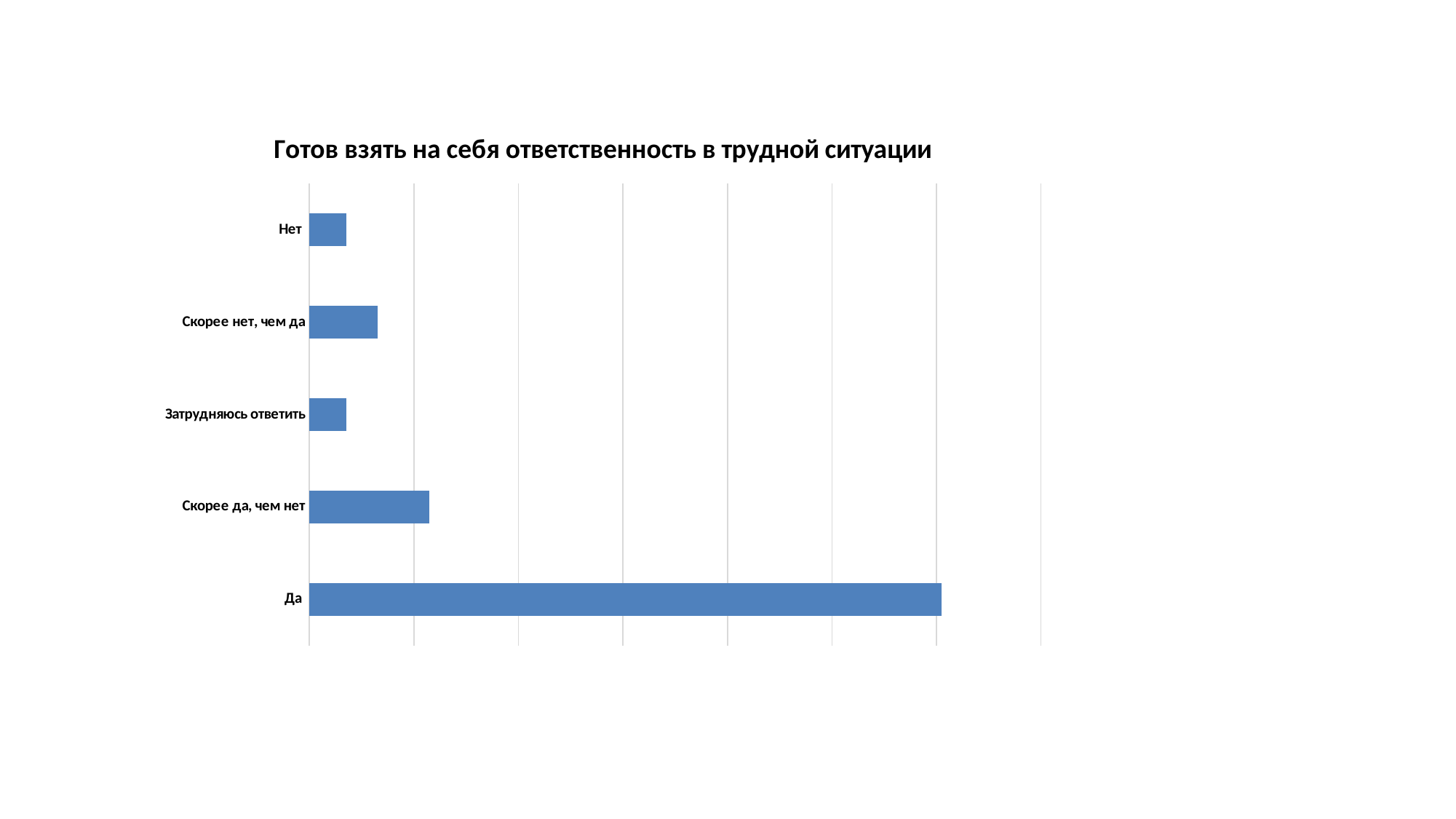
What colour are the bars in the chart? Blue Which is larger, the value for "Скорее нет, чем да" or the value for "Нет"? Скорее нет, чем да Which is larger, the value for "Да" or the value for "Скорее да, чем нет"? Да What kind of chart is shown on the slide? Bar chart Which is larger, the value for "Скорее да, чем нет" or the value for "Скорее нет, чем да"? Скорее да, чем нет How many categories are shown in the chart? 5 What is the title of the chart? Готов взять на себя ответственность в трудной ситуации Which category has the highest value in the chart? Да